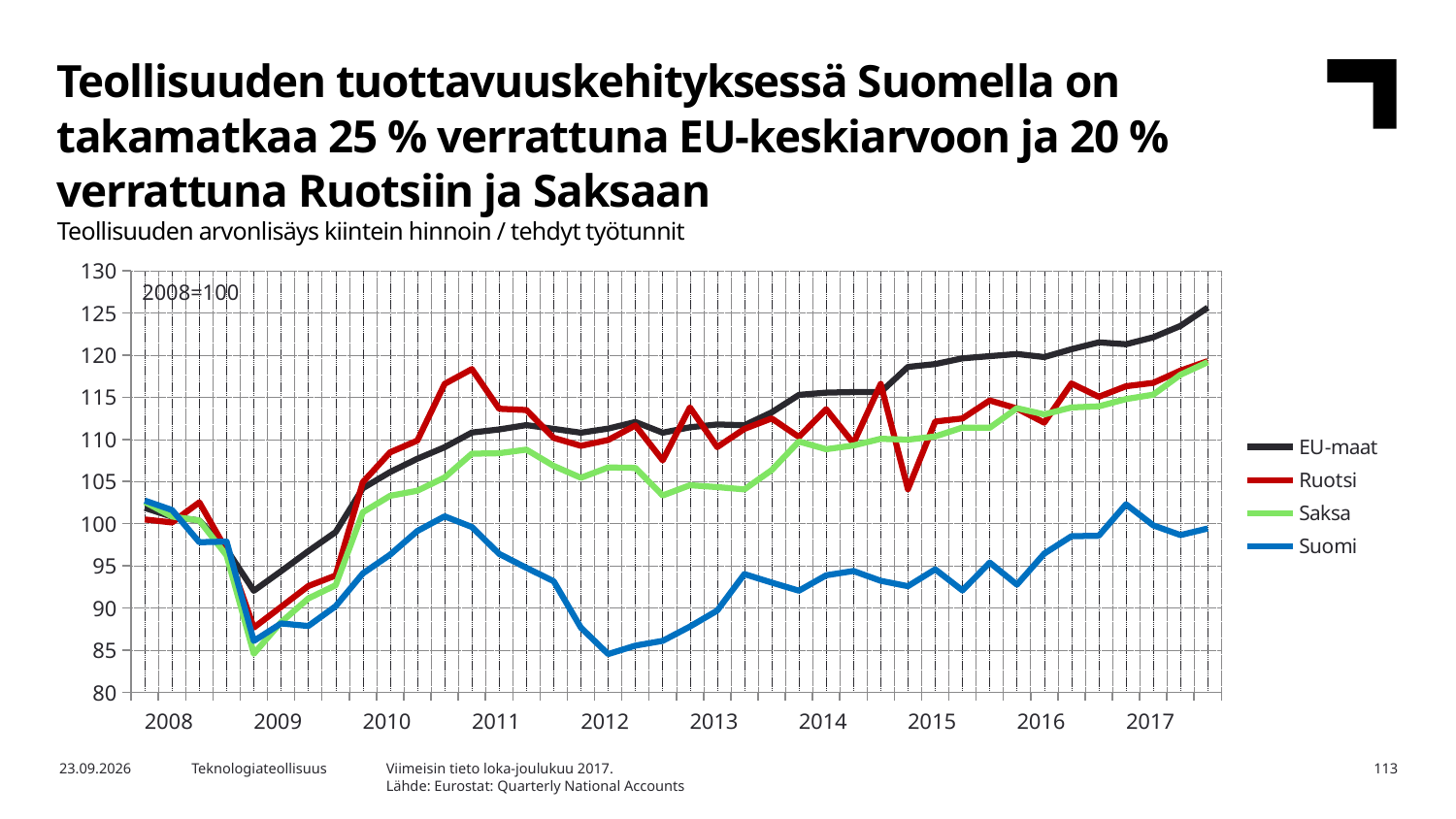
Does the EU-maat series generally rise or fall from 2010 to 2017? rise Is the value for EU-maat at the end of 2017 greater or less than 120? greater In 2012, which series is higher, Saksa or Suomi? Saksa How many years are labelled on the x axis? 10 Which series has the lowest value at the end of 2017? Suomi What kind of chart is shown on the slide? line chart What base-year note is printed inside the chart area? 2008=100 How many series does the legend list? 4 Is the lowest value for Suomi, reached in 2012, greater or less than 90? less Which series are listed in the legend? EU-maat, Ruotsi, Saksa, Suomi Which series has the highest value at the end of 2017? EU-maat Is the peak value for Ruotsi in 2010 greater or less than 115? greater